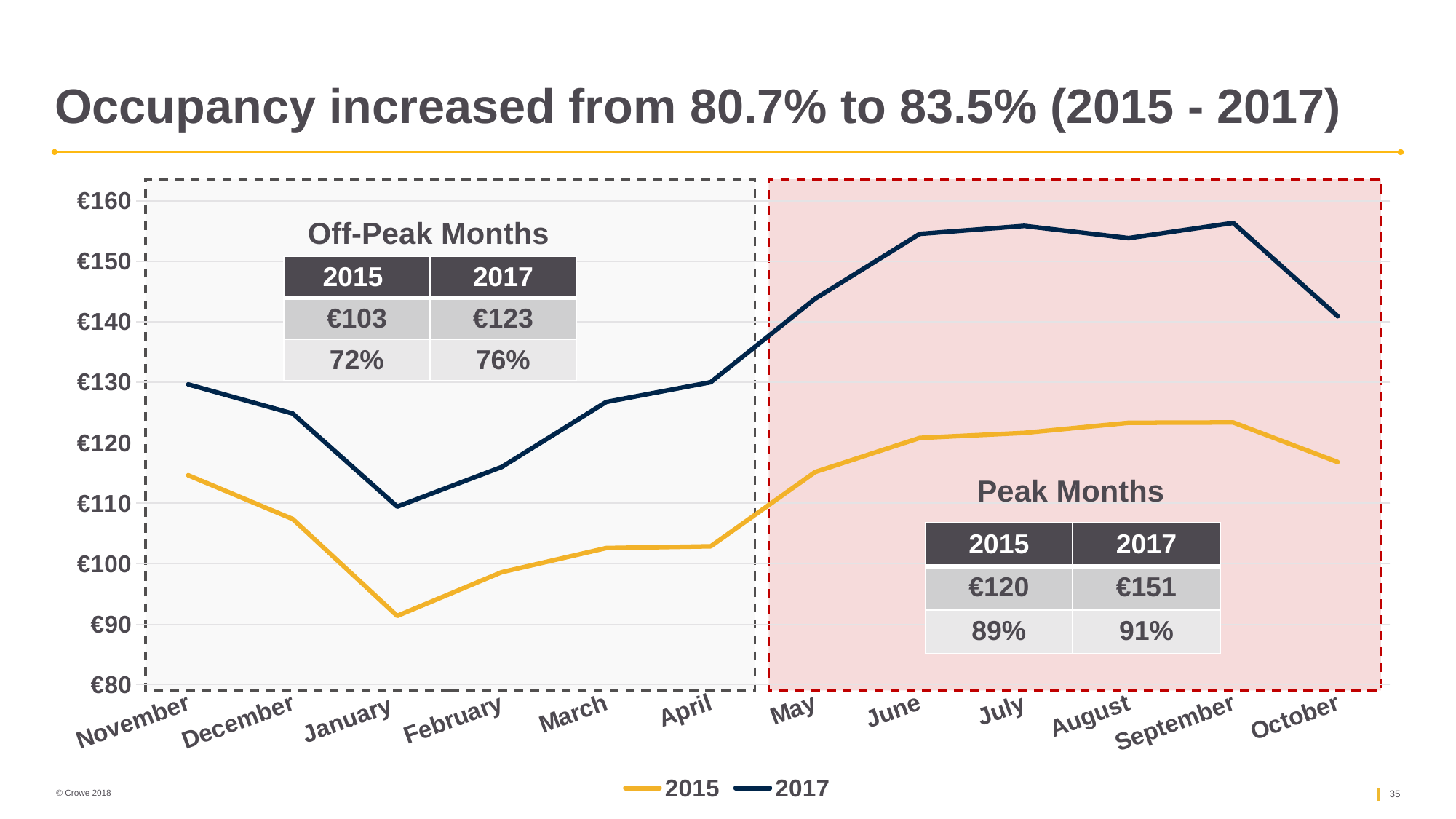
In which month is the 2017 line at its lowest? January What type of chart is shown on the slide? line chart In which month is the 2015 line at its lowest? January Does the 2017 line rise or fall from January to June? rises Is the 2015 value for January greater or less than €100? less How many months are shown along the x axis? 12 Does the 2015 line rise or fall from November to January? falls What colour is the 2017 line in the legend? dark navy blue Is the 2017 value for July greater or less than €150? greater Is the 2015 value for May greater or less than €110? greater How many series does the legend list? 2 In June, which series has the higher value, 2015 or 2017? 2017